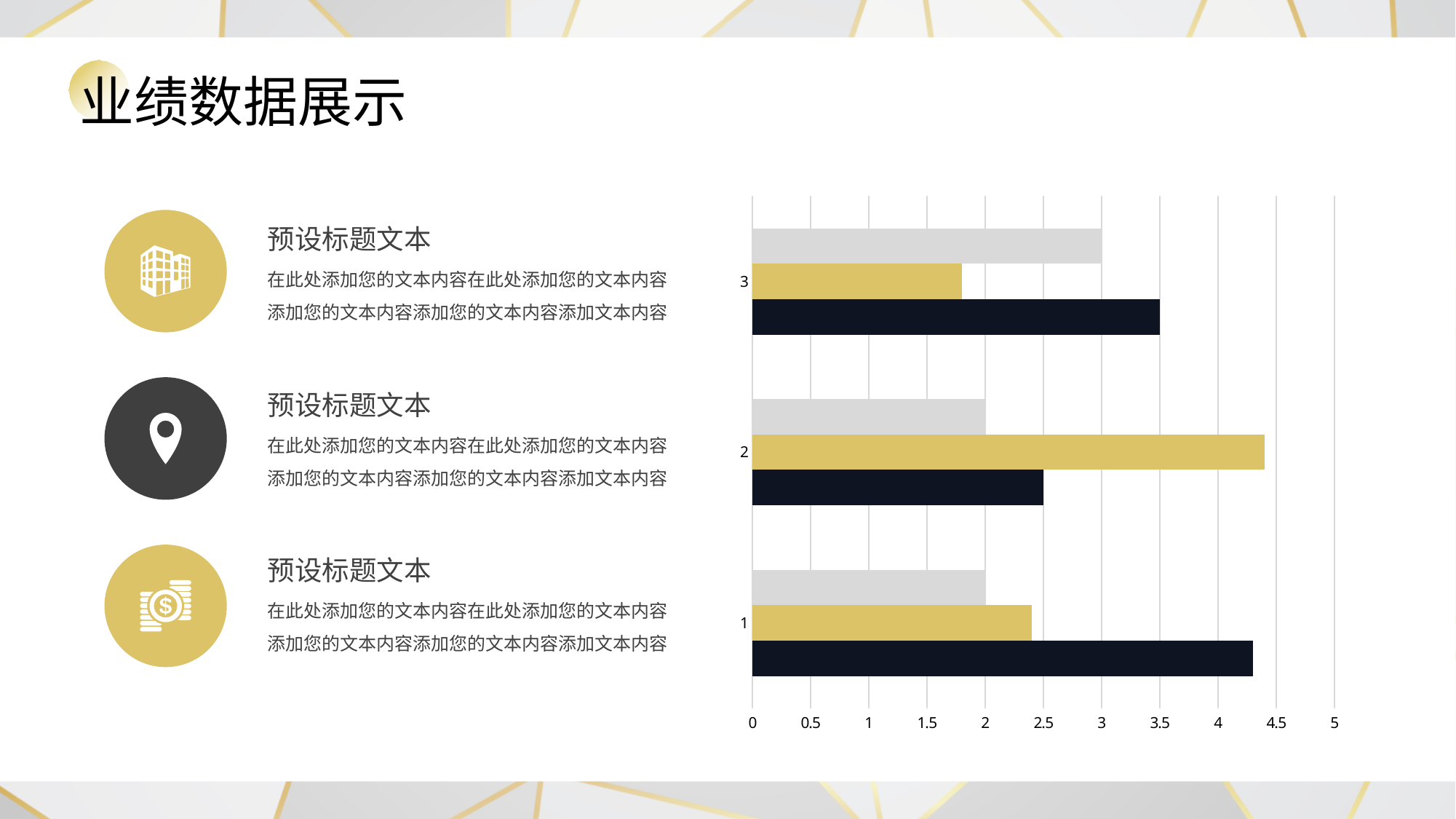
Is the value of the gold bar for category 3 greater or less than 2? less What is the value of the gray bar for category 2? 2 Which category has the longest black bar? 1 Which category has the shortest gold bar? 3 What is the value of the black bar for category 3? 3.5 Is the value of the gold bar for category 2 greater or less than 4? greater How many categories are shown on the vertical axis of the chart? 3 What is the difference between the black bar for category 3 and the black bar for category 2? 1 What kind of chart is shown on the slide? bar chart For category 1, which bar is longer, the gray bar or the black bar? the black bar What is the value of the gray bar for category 3? 3 What is the value of the black bar for category 2? 2.5